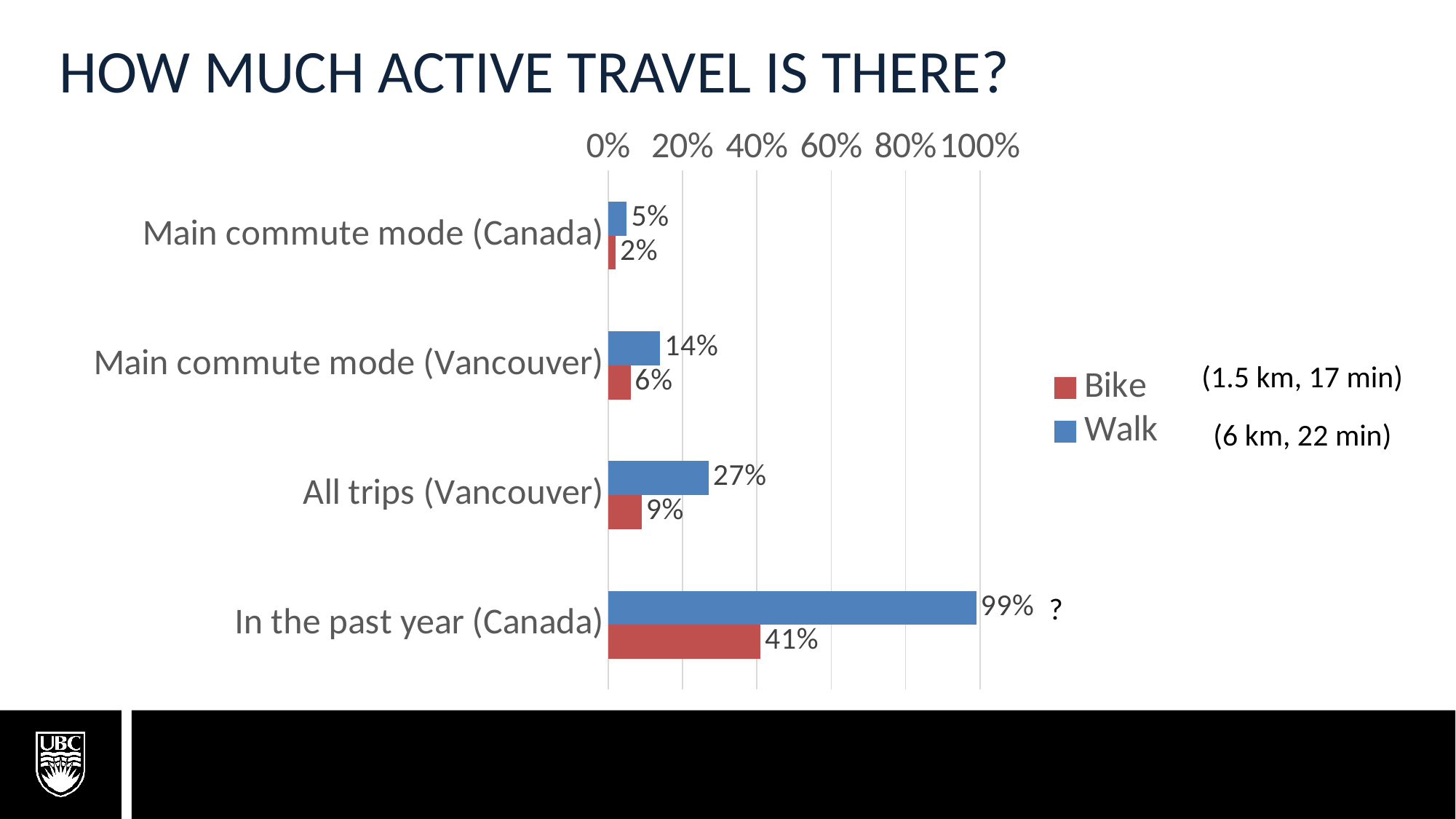
Which category has the highest Walk value? In the past year (Canada) What is the Walk value for All trips (Vancouver)? 27% How many series does the legend list? 2 What is the Walk value for Main commute mode (Vancouver)? 14% What is the Bike value for In the past year (Canada)? 41% Which is larger: the Walk value for Main commute mode (Vancouver) or the Bike value for All trips (Vancouver)? Walk value for Main commute mode (Vancouver) What is the Bike value for Main commute mode (Canada)? 2% What is the difference between the Walk and Bike values for All trips (Vancouver)? 18% How many categories are shown on the chart? 4 What colour represents the Bike series? Red Which category has the lowest Bike value? Main commute mode (Canada) What kind of chart is shown on the slide? Bar chart